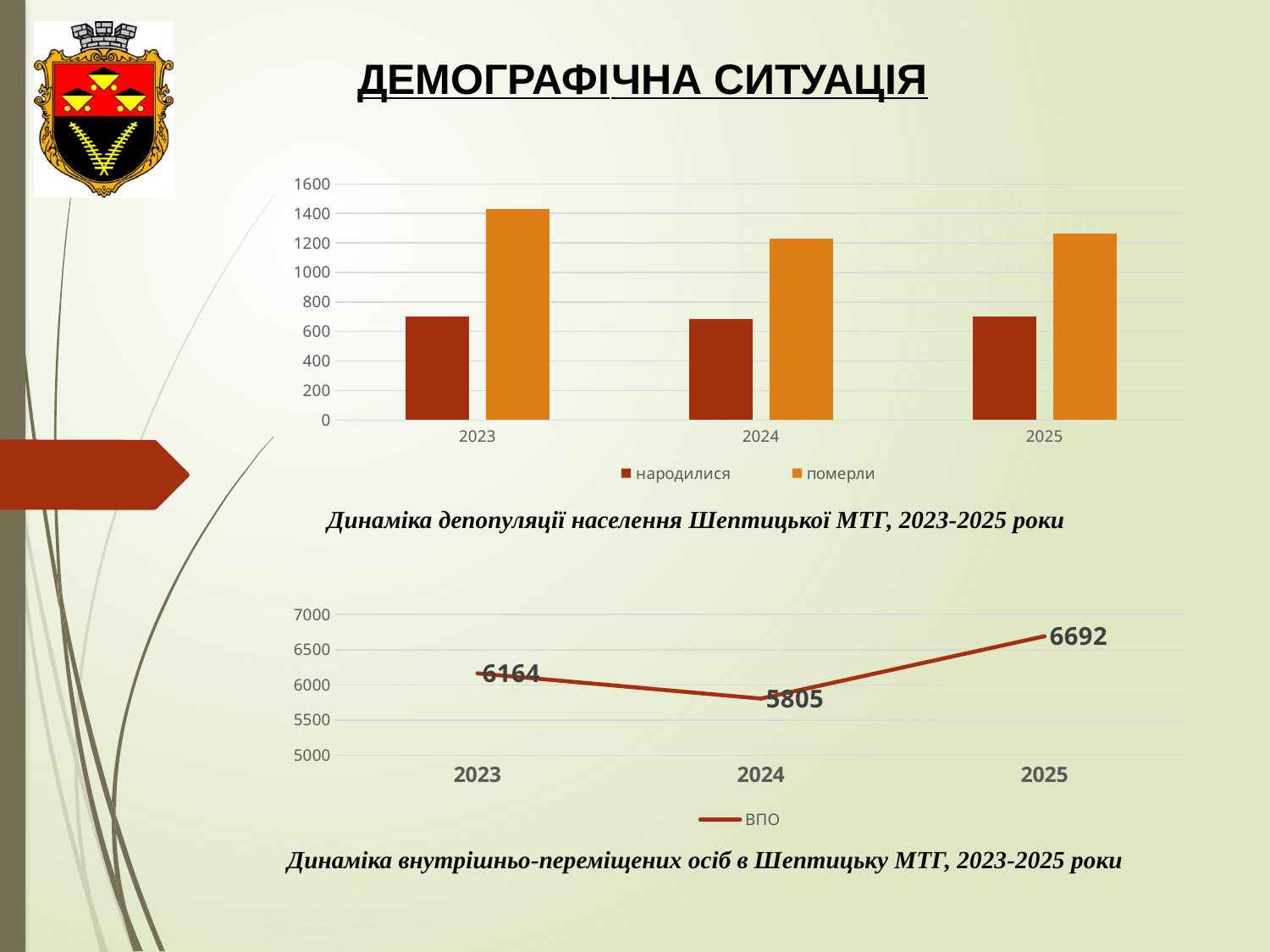
In the bottom line chart, what is the value of ВПО in 2024? 5805 In the top bar chart, which is larger in 2025: народилися or померли? померли In the bottom line chart, what is the value of ВПО in 2025? 6692 In the bottom line chart, what is the difference between the ВПО values for 2025 and 2023? 528 In the top bar chart, is the value for народилися in 2024 greater or less than 800? less In the bottom line chart, which year has the lowest value of ВПО? 2024 What kind of chart is the top chart on the slide? bar chart In the top bar chart, which year has the highest value for померли? 2023 In the top bar chart, how many series does the legend list? 2 In the top bar chart, is the value for померли in 2023 greater or less than 1400? greater What kind of chart is the bottom chart on the slide? line chart In the bottom line chart, how many data points are plotted? 3